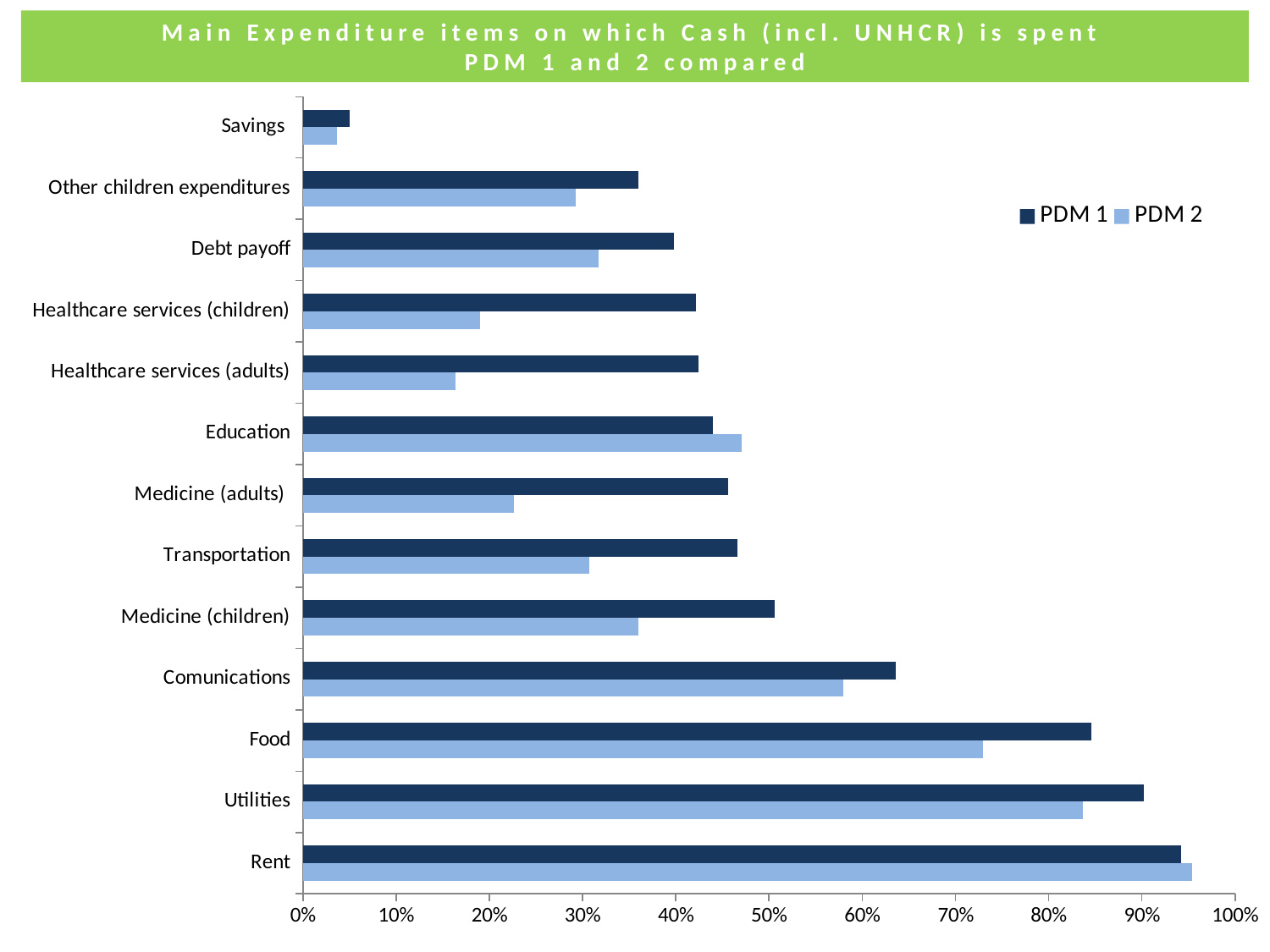
For Healthcare services (children), which series has the larger value, PDM 1 or PDM 2? PDM 1 Is the PDM 1 value for Food greater or less than 80%? greater Which category has the lowest value for PDM 2? Savings Is the PDM 2 value for Healthcare services (adults) greater or less than 20%? less Is the PDM 1 value for Comunications greater or less than 60%? greater How many expenditure categories are shown on the chart? 13 For Education, which series has the larger value, PDM 1 or PDM 2? PDM 2 How many series does the legend list? 2 What kind of chart is shown on the slide? bar chart Which category has the highest value for PDM 2? Rent Which category has the highest value for PDM 1? Rent